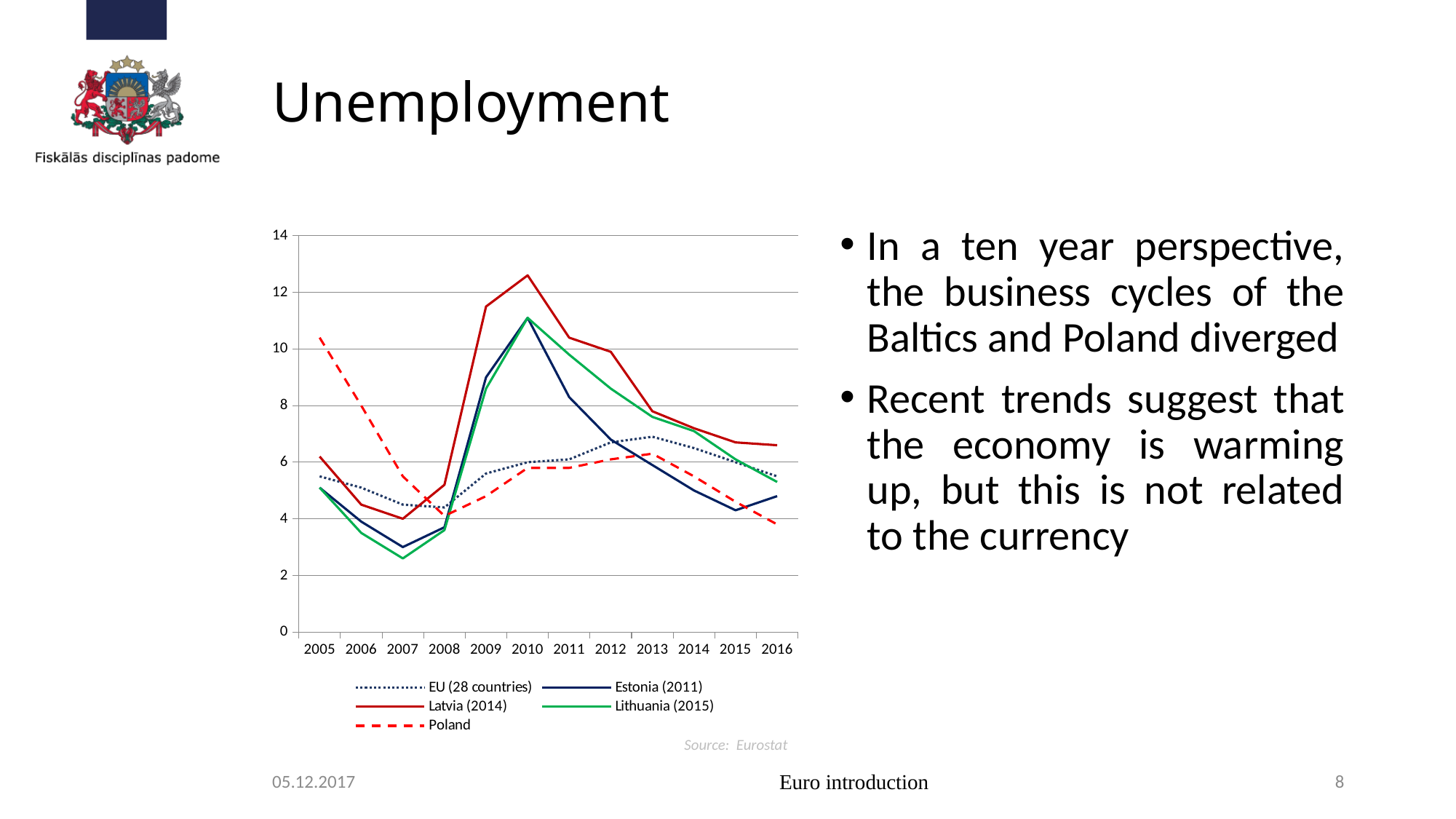
Which series has the highest value in 2010? Latvia (2014) How many series does the legend list? 5 Does the Latvia (2014) series rise or fall from 2010 to 2016? fall Which series has the lowest value in 2007? Lithuania (2015) Is the value for Latvia (2014) in 2010 greater or less than 12? greater Is the value for Estonia (2011) in 2015 greater or less than 6? less Is the value for Lithuania (2015) in 2007 greater or less than 4? less What source is cited below the chart? Eurostat What kind of chart is shown on the slide? line chart In 2016, which is larger: the value for Latvia (2014) or the value for Poland? Latvia (2014) In which year does the Latvia (2014) series reach its peak? 2010 How many years are shown on the x axis? 12